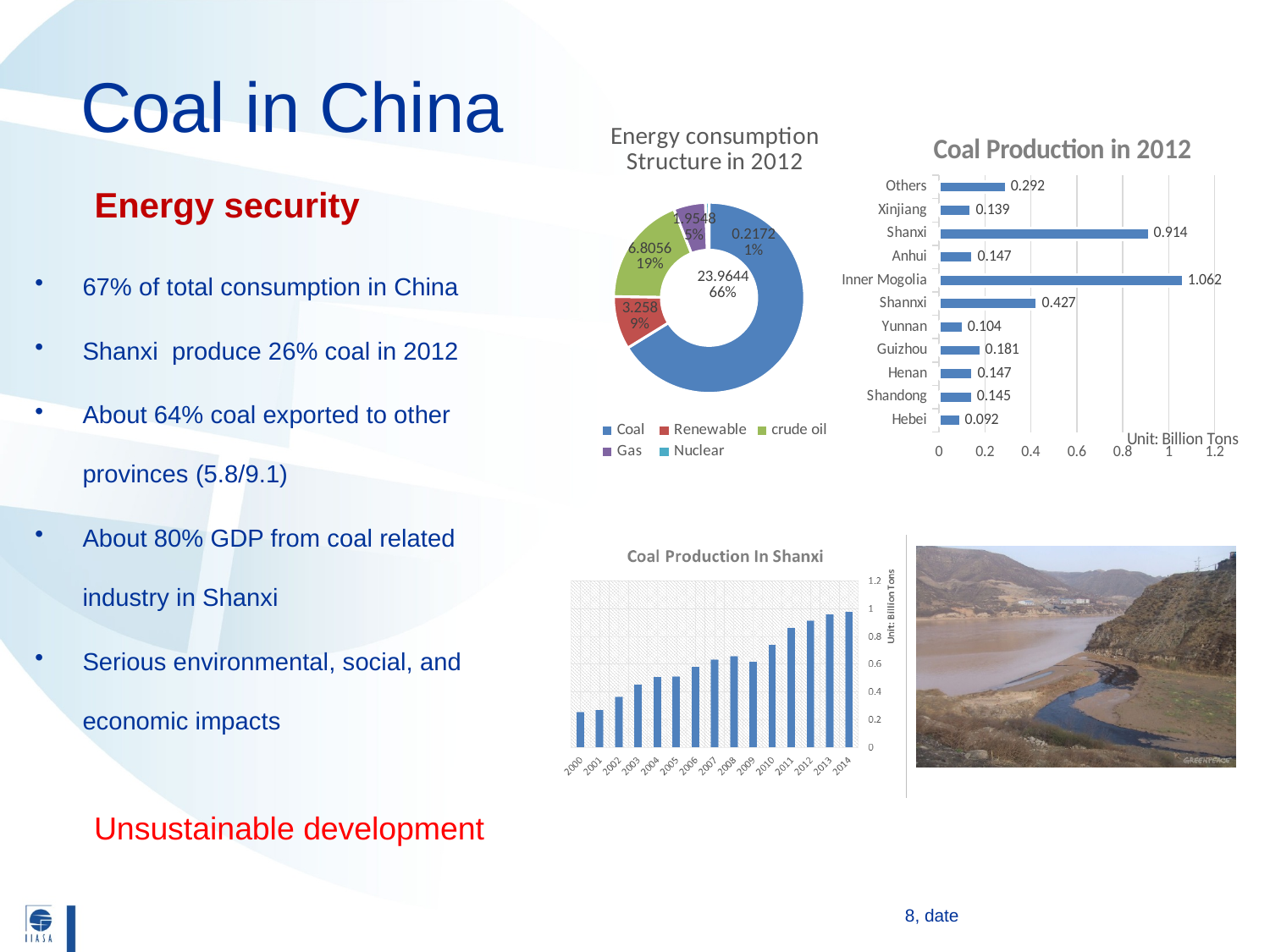
In the 'Coal Production In Shanxi' chart, do the values generally rise or fall from 2000 to 2014? Rise In the 'Energy consumption Structure in 2012' chart, what is the value for crude oil? 6.8056 In the 'Coal Production in 2012' chart, which province has the highest coal production? Inner Mogolia How many categories are shown in the 'Coal Production in 2012' chart? 11 In the 'Coal Production in 2012' chart, which province has the lowest coal production? Hebei In the 'Coal Production in 2012' chart, which is larger, Guizhou or Xinjiang? Guizhou What kind of chart is 'Coal Production In Shanxi'? Bar chart In the 'Coal Production in 2012' chart, what is the difference between Inner Mogolia and Shanxi? 0.148 In the 'Coal Production in 2012' chart, what is the value for Shanxi? 0.914 In the 'Coal Production In Shanxi' chart, is the value for 2014 greater or less than 0.8? greater How many entries does the legend of the 'Energy consumption Structure in 2012' chart list? 5 In the 'Energy consumption Structure in 2012' chart, what share does Coal have? 66%